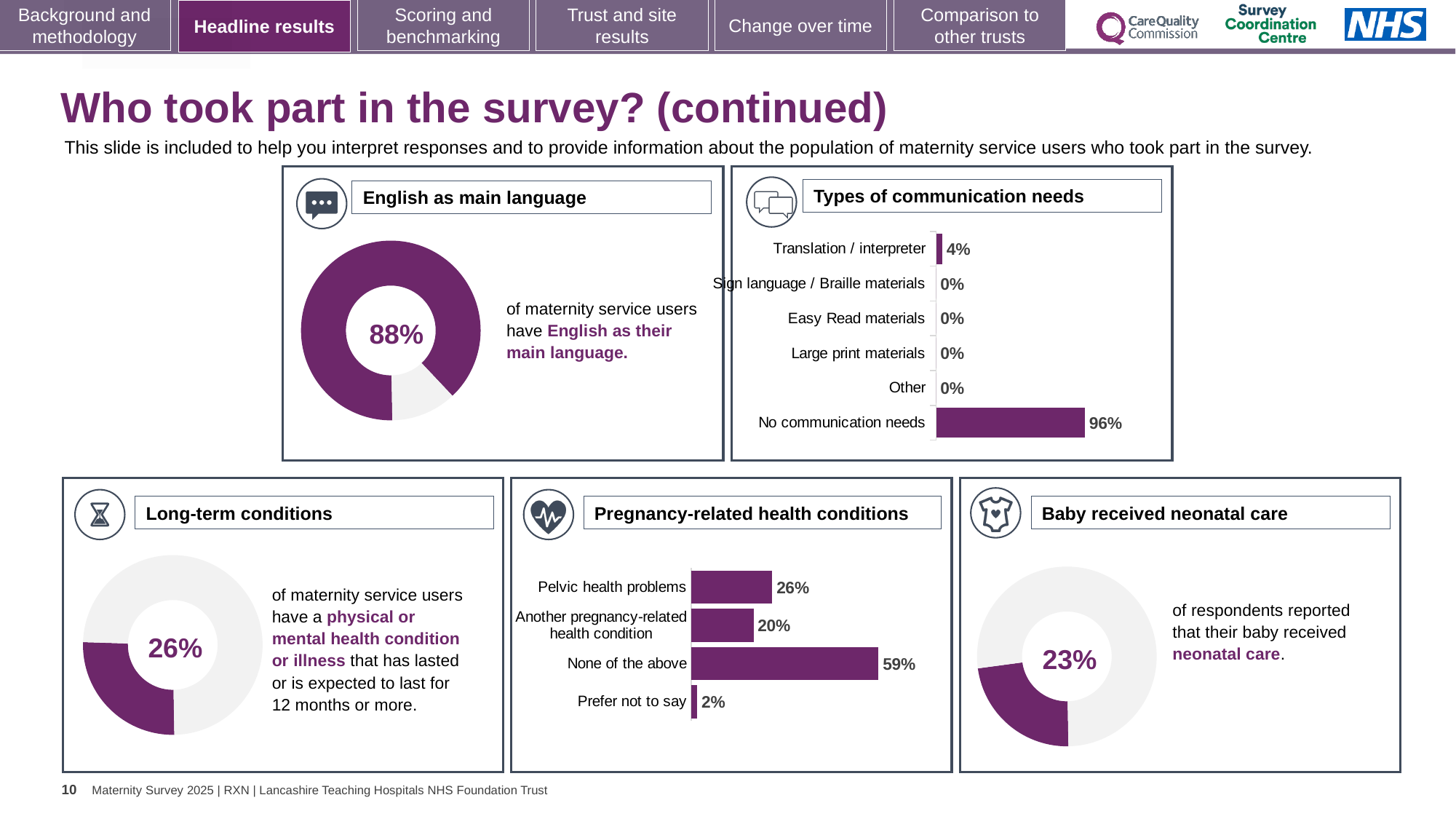
What kind of chart is the 'Pregnancy-related health conditions' chart? Bar chart In the 'Pregnancy-related health conditions' chart, what is the value for 'Pelvic health problems'? 26% In the 'Types of communication needs' chart, how many categories are shown? 6 In the 'Types of communication needs' chart, what is the value for 'Translation / interpreter'? 4% In the 'Types of communication needs' chart, which category has the highest value? No communication needs In the 'English as main language' chart, what share of maternity service users have English as their main language? 88% In the 'Types of communication needs' chart, what is the difference between 'No communication needs' and 'Translation / interpreter'? 92% What kind of chart is the 'Long-term conditions' chart? Donut chart In the 'Baby received neonatal care' chart, what percentage of respondents reported that their baby received neonatal care? 23% In the 'Pregnancy-related health conditions' chart, which category has the lowest value? Prefer not to say In the 'Pregnancy-related health conditions' chart, which is larger: 'Pelvic health problems' or 'Another pregnancy-related health condition'? Pelvic health problems In the 'Pregnancy-related health conditions' chart, what is the difference between 'None of the above' and 'Another pregnancy-related health condition'? 39%